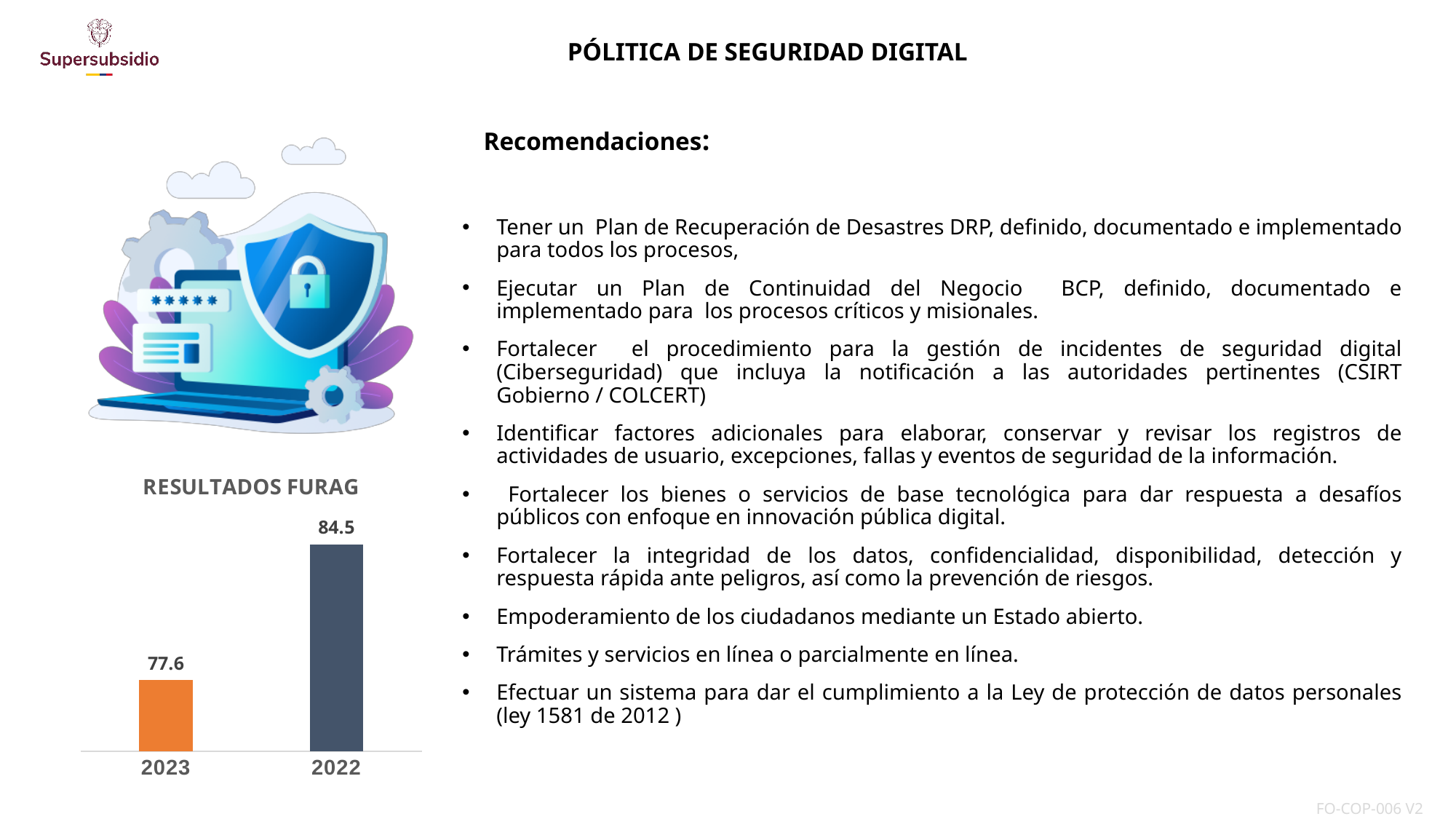
Which year has the lowest value in the RESULTADOS FURAG chart? 2023 What is the value for 2022 in the RESULTADOS FURAG chart? 84.5 What is the value for 2023 in the RESULTADOS FURAG chart? 77.6 What is the difference between the 2022 and 2023 values in the RESULTADOS FURAG chart? 6.9 What kind of chart is the RESULTADOS FURAG chart? bar chart What is the title of the chart on the slide? RESULTADOS FURAG Do the values in the RESULTADOS FURAG chart rise or fall from left to right along the x axis? rise In the RESULTADOS FURAG chart, is the value for 2023 larger or smaller than the value for 2022? smaller What colour is the bar for 2023 in the RESULTADOS FURAG chart? orange How many categories are shown in the RESULTADOS FURAG chart? 2 Which year has the highest value in the RESULTADOS FURAG chart? 2022